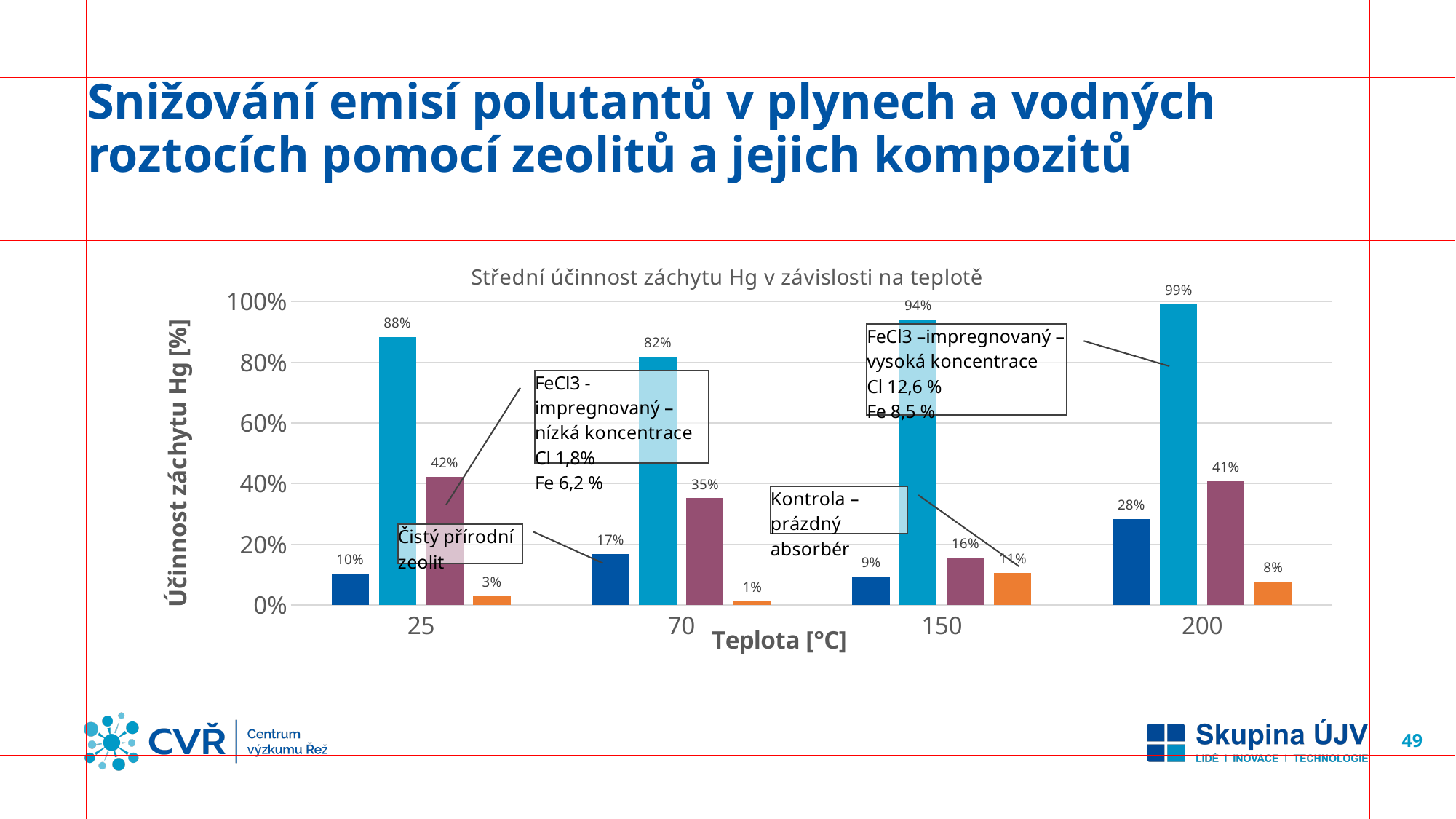
What is the label of the y axis? Účinnost záchytu Hg [%] What type of chart is shown on the slide? bar chart What is the Hg capture efficiency of the FeCl3-impregnated high-concentration zeolite (light blue bars) at 200 °C? 99% What is the title of the chart? Střední účinnost záchytu Hg v závislosti na teplotě At which temperature is the Kontrola – prázdný absorbér (orange) bar lowest? 70 Which is larger at 150 °C: the purple bar (FeCl3 nízká koncentrace) or the orange bar (Kontrola)? purple bar (16%) At which temperature does the FeCl3-impregnated high-concentration zeolite (light blue bars) reach its highest efficiency? 200 What is the value of the Kontrola – prázdný absorbér (orange) bar at 70 °C? 1% What is the difference between the light blue bar and the purple bar at 25 °C? 46% How many temperature categories are shown on the x axis? 4 Do the values of the light blue bars (FeCl3 vysoká koncentrace) rise or fall from 70 °C to 200 °C? rise What is the value of the Čistý přírodní zeolit (dark blue) bar at 150 °C? 9%